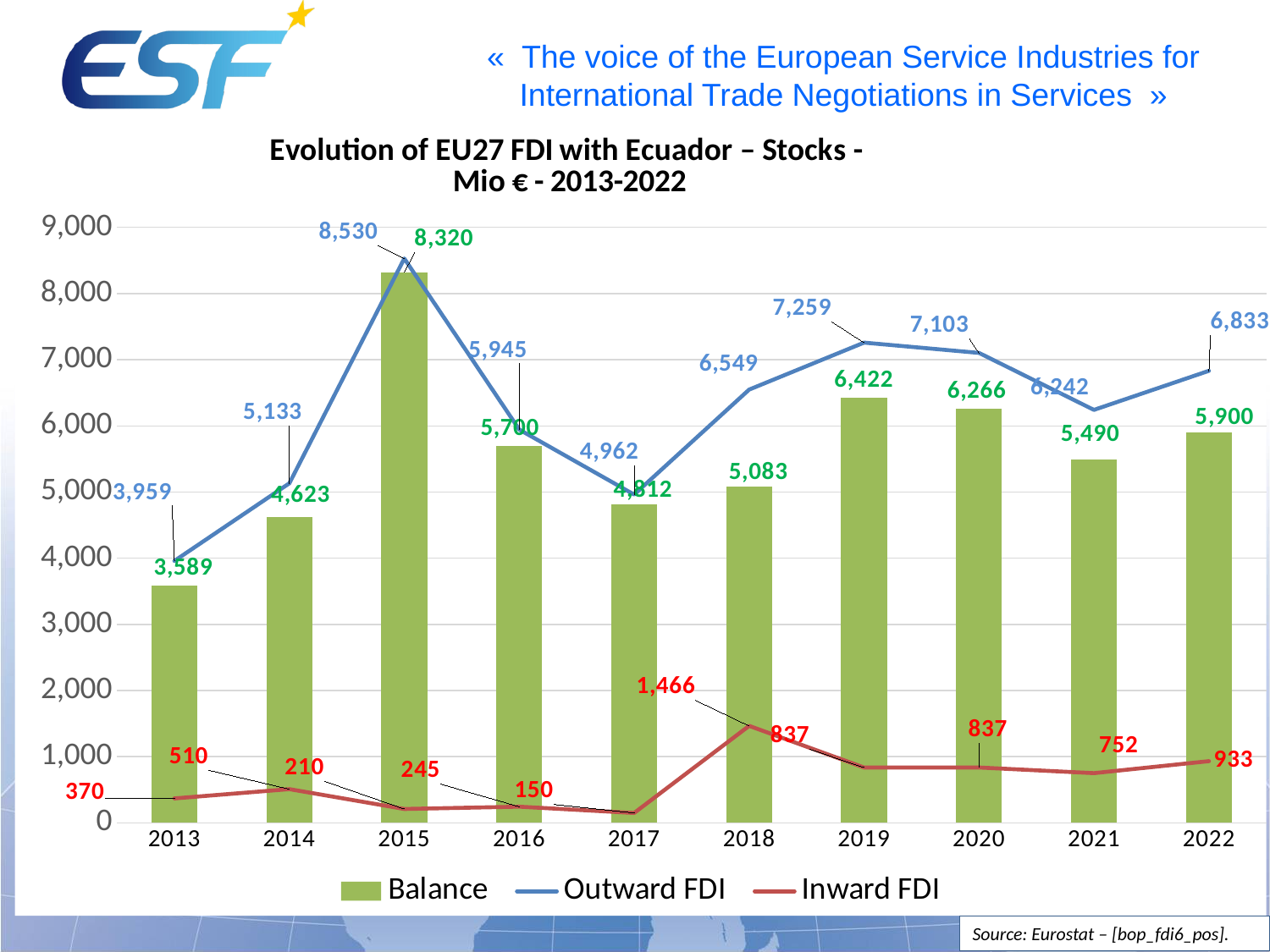
Which year has the larger Balance, 2020 or 2021? 2020 In which year is Outward FDI highest? 2015 What is the Balance value for 2019? 6,422 In which year is the Balance lowest? 2013 What is the Inward FDI value for 2022? 933 What kind of chart is used to show the Balance series? Bar chart How many years are shown on the x axis? 10 What is the Outward FDI value for 2015? 8,530 Does Outward FDI rise or fall from 2019 to 2021? Fall In which year is Inward FDI highest? 2018 What is the difference between Outward FDI in 2022 and in 2021? 591 How many series does the legend list? 3